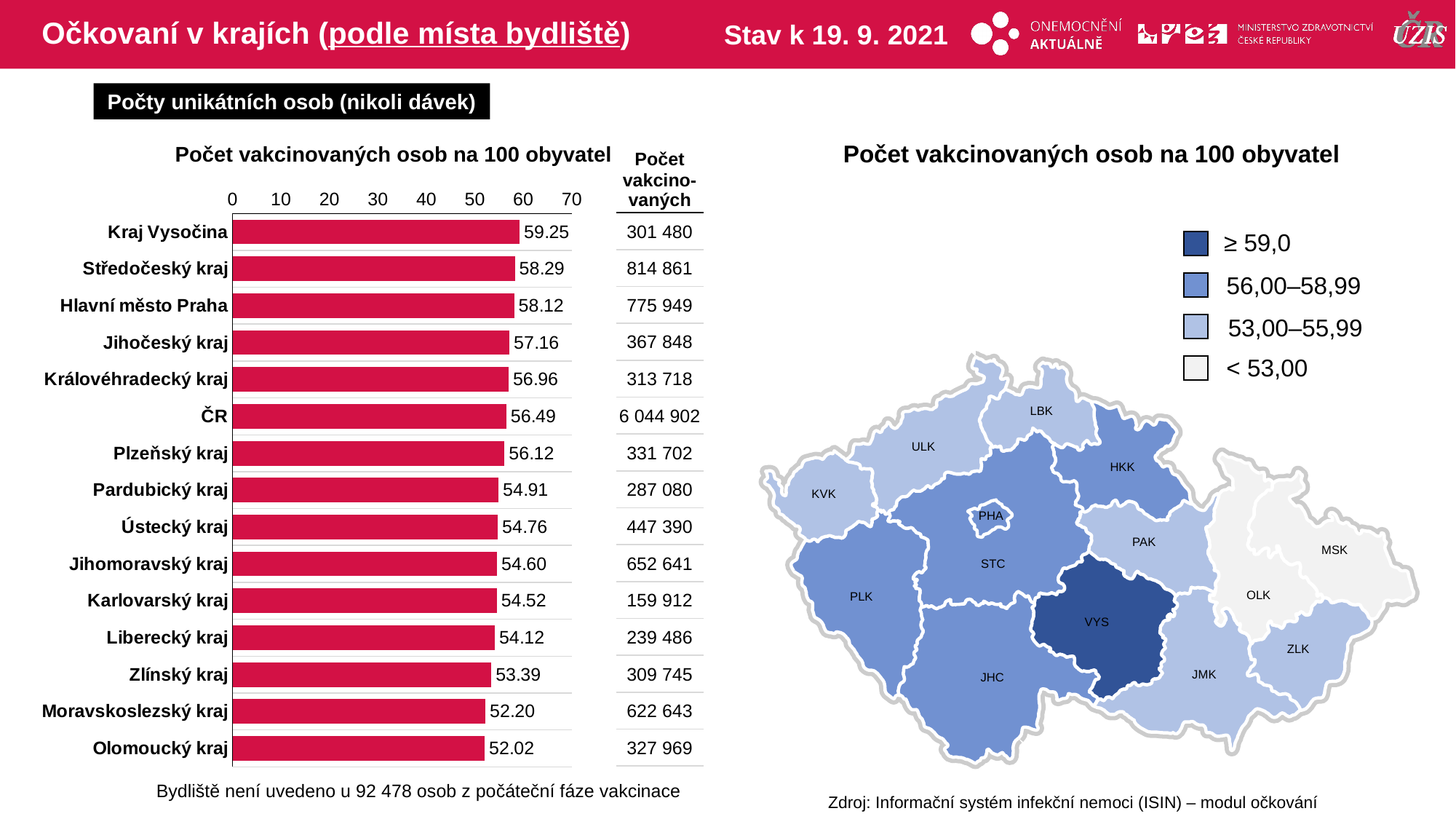
In the bar chart, is the value for Moravskoslezský kraj greater or less than 60? less In the bar chart, what is the value for Hlavní město Praha? 58.12 Which category has the highest value in the bar chart? Kraj Vysočina In the bar chart, what is the value for ČR? 56.49 Which category has the lowest value in the bar chart? Olomoucký kraj In the bar chart, what is the difference between the values for Kraj Vysočina and Olomoucký kraj? 7.23 In the bar chart, which has a larger value: Jihočeský kraj or Plzeňský kraj? Jihočeský kraj How many bars are shown in the bar chart? 15 How many categories does the legend of the map on the right list? 4 What kind of chart is shown on the left side of the slide? bar chart In the bar chart, what is the value for Zlínský kraj? 53.39 In the bar chart, what is the value for Kraj Vysočina? 59.25